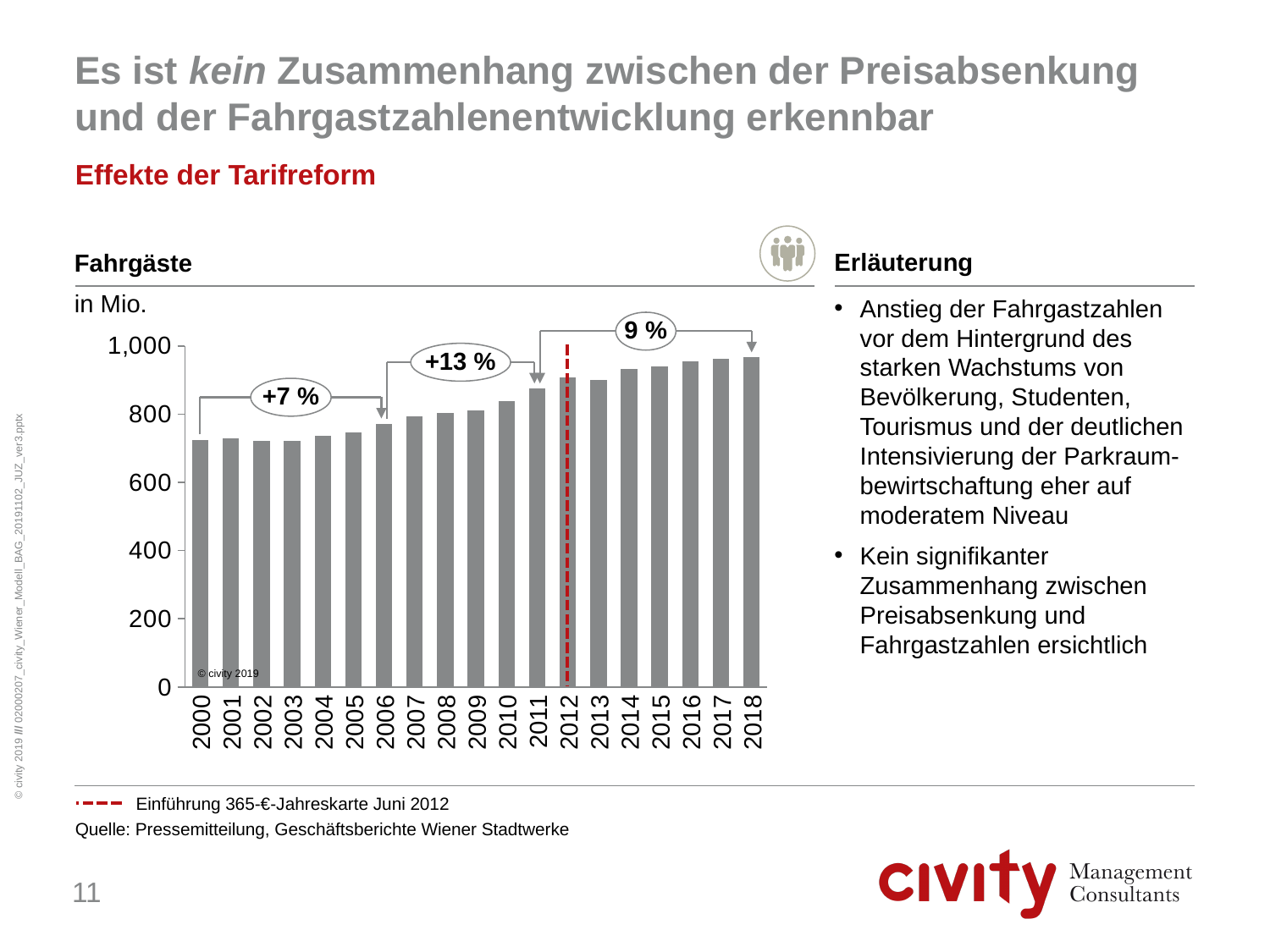
What kind of chart is shown on the slide? bar chart Is the value for 2012 greater or less than 800? greater Is the value for 2018 greater or less than 1,000? less What percentage change is annotated for the period from 2006 to 2011? +13 % How many years are shown on the x axis of the Fahrgäste chart? 19 What does the red dashed line in the chart mark? Einführung 365-€-Jahreskarte Juni 2012 Is the value for 2000 greater or less than 800? less Do the passenger numbers generally rise or fall from 2000 to 2018? rise Which year has the larger value, 2006 or 2011? 2011 Which year has the larger value, 2000 or 2018? 2018